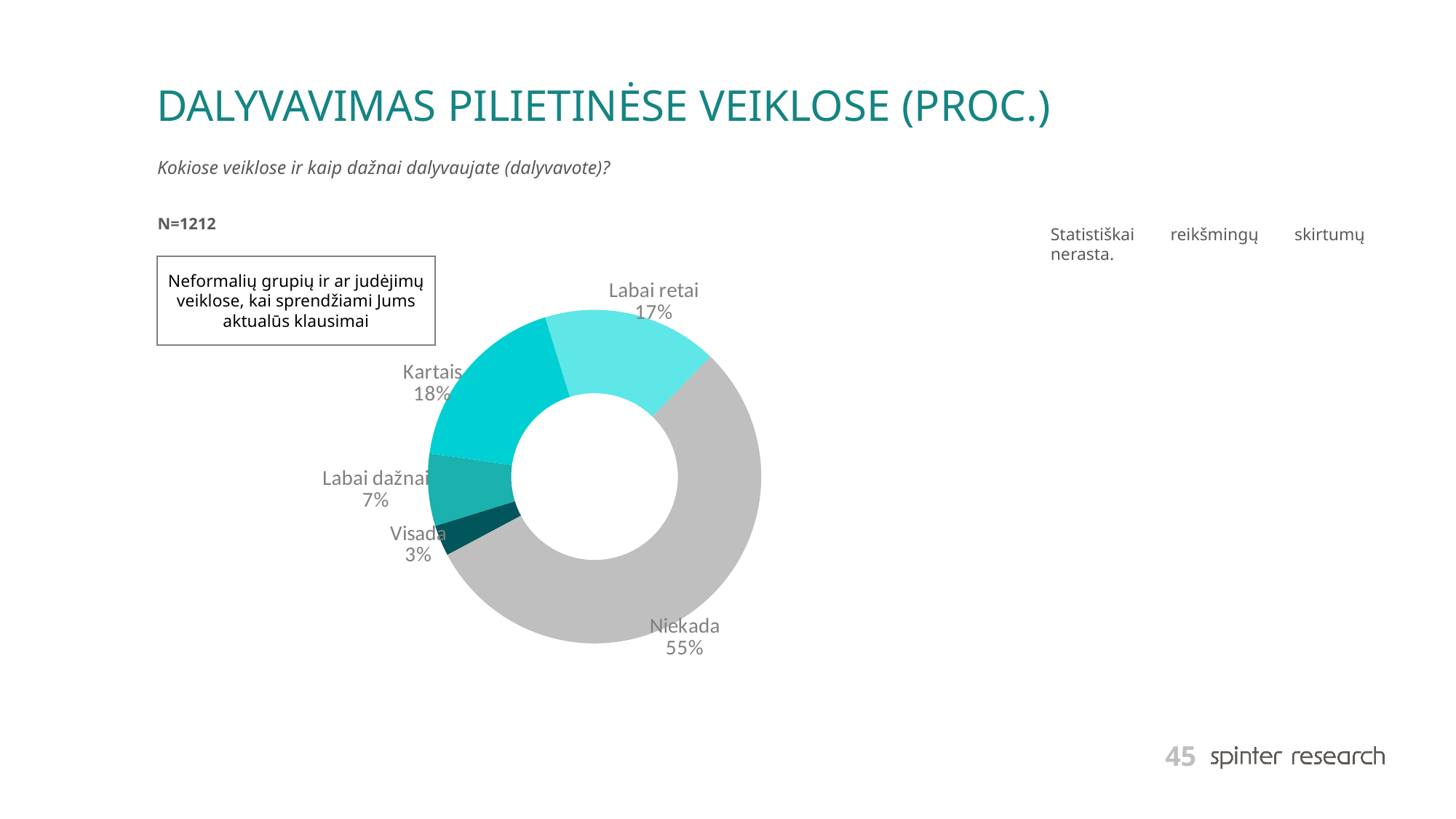
What percentage of respondents answered "Labai dažnai"? 7% How many categories are shown in the pie chart? 5 What is the sample size (N) stated on the slide? N=1212 What type of chart is shown on the slide? Pie chart (doughnut) Which category has the smallest share of the pie? Visada Which category has the largest share of the pie? Niekada What is the difference in percentage points between "Niekada" and "Kartais"? 37 What percentage of respondents answered "Niekada"? 55% What percentage of respondents answered "Visada"? 3% What percentage of respondents answered "Labai retai"? 17% What percentage of respondents answered "Kartais"? 18% Which is larger, the share for "Labai dažnai" or the share for "Visada"? Labai dažnai